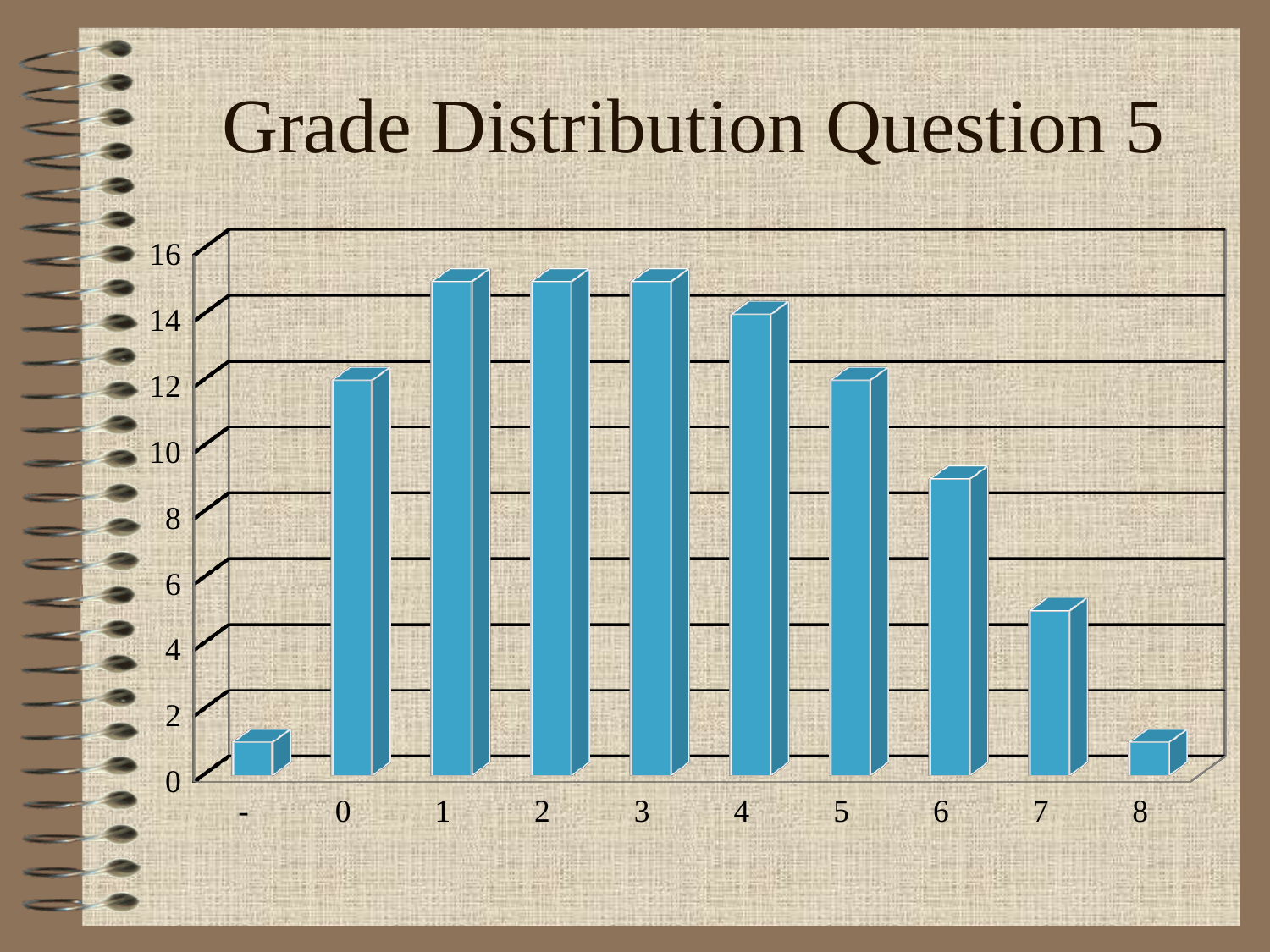
What is the highest value shown on the vertical axis? 16 Do the values rise or fall along the x axis from category 3 to category 8? fall Which has the larger value, category 7 or category 4? 4 Is the value for category 8 greater or less than 2? less Which has the larger value, category 0 or category 6? 0 Is the value for category 7 greater or less than 6? less What is the title of the chart? Grade Distribution Question 5 Is the value for category 6 greater or less than 10? less What kind of chart is shown on the slide? bar chart How many categories are shown on the x axis? 10